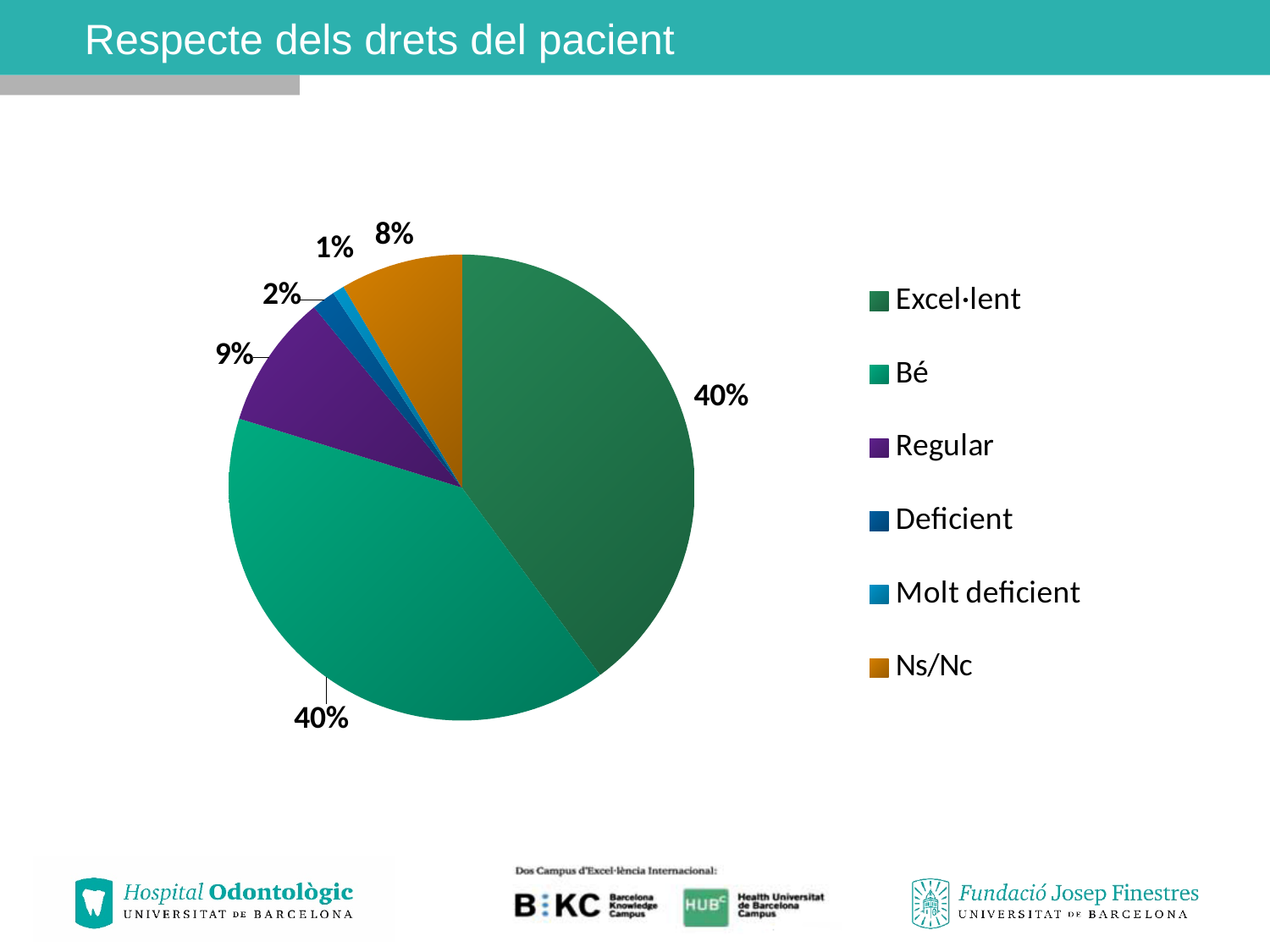
What percentage of the pie corresponds to Excel·lent? 40% Which legend entry is shown in orange? Ns/Nc What kind of chart is shown on the slide? Pie chart What percentage of the pie corresponds to Ns/Nc? 8% How many categories does the legend list? 6 Which category has the smallest slice of the pie? Molt deficient What percentage of the pie corresponds to Deficient? 2% What percentage of the pie corresponds to Regular? 9% Which is larger, the slice for Regular or the slice for Deficient? Regular What is the difference in percentage points between Regular and Ns/Nc? 1 What is the combined share of Excel·lent and Bé? 80% What is the title of the slide containing the chart? Respecte dels drets del pacient